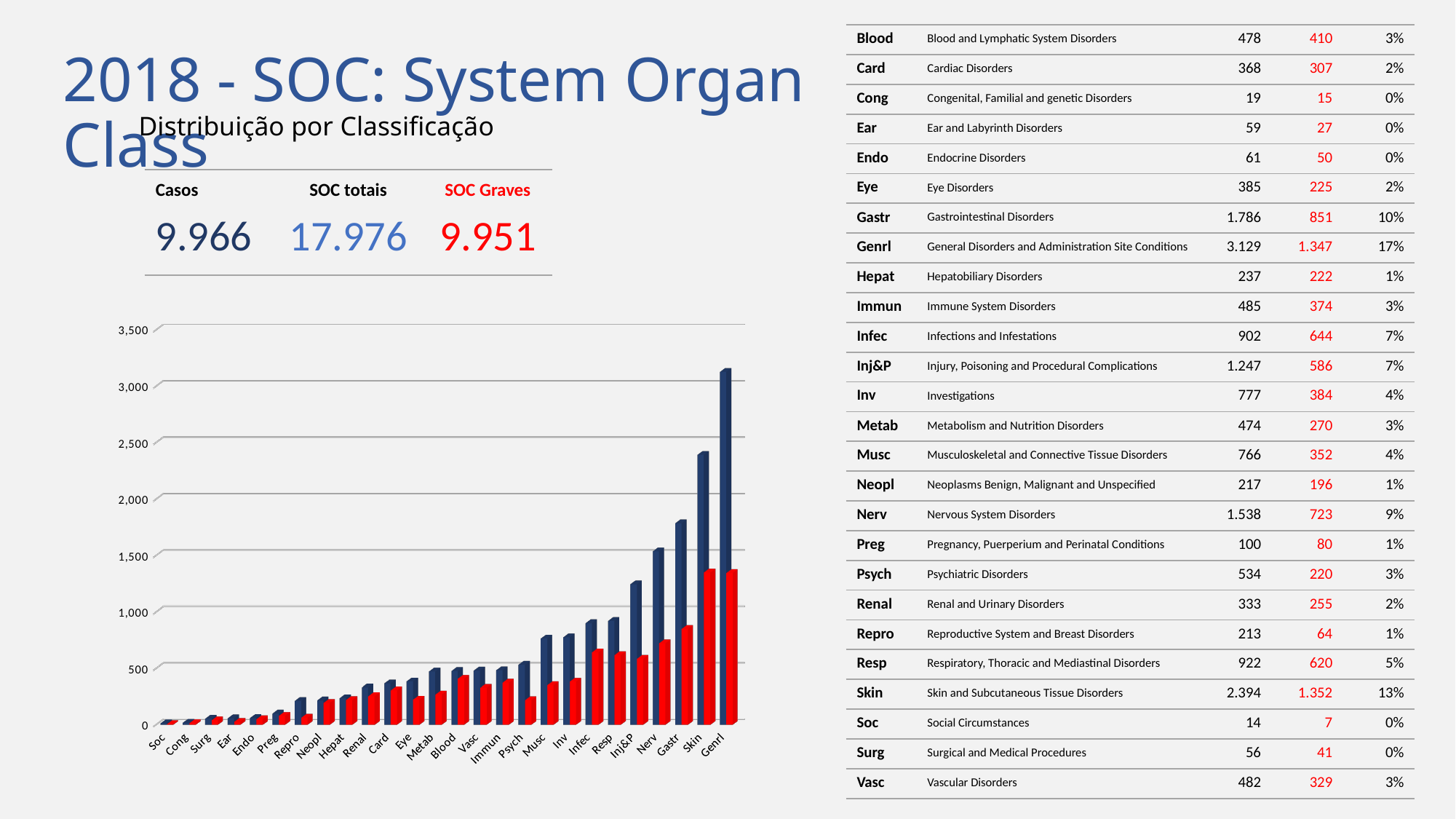
Is the blue bar for Genrl greater or less than 3,000? greater Which category has the tallest blue bar in the chart? Genrl What kind of chart is shown on the slide? bar chart Is the blue bar for Inj&P greater or less than 1,000? greater Which has the taller blue bar, Skin or Gastr? Skin Do the bar heights generally rise or fall moving from left to right along the x axis? rise Is the blue bar for Infec greater or less than 1,000? less Which category has the shortest bars in the chart? Soc How many categories are plotted along the x axis of the bar chart? 26 How many data series are plotted in the bar chart? 2